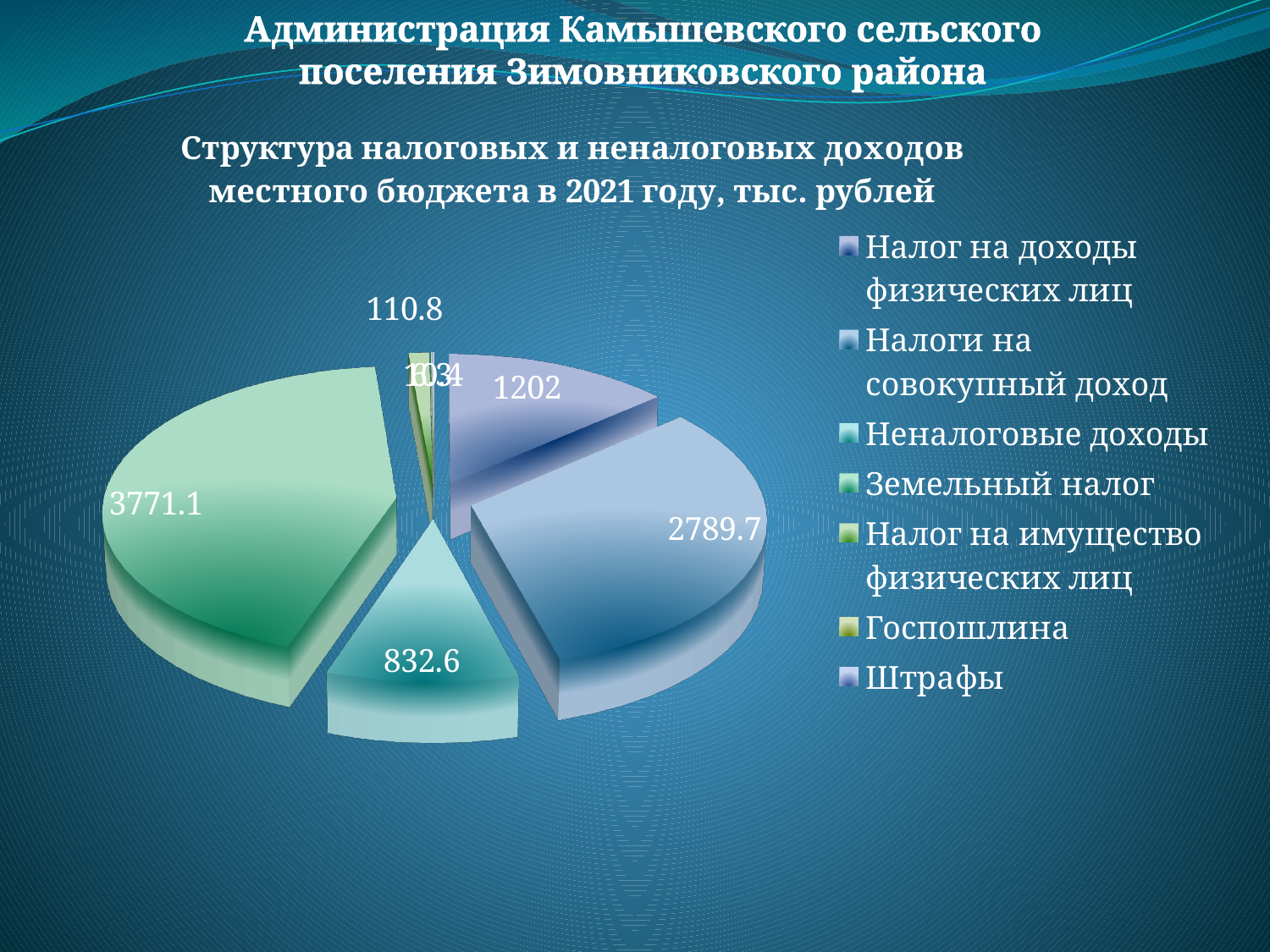
Which category has the largest slice of the pie? Земельный налог In what units are the values of the chart given, according to its title? тыс. рублей What is the difference between the values for Земельный налог and Налоги на совокупный доход? 981.4 What kind of chart is shown on the slide? Pie chart What is the value for Налоги на совокупный доход? 2789.7 What is the difference between the values for Налог на доходы физических лиц and Неналоговые доходы? 369.4 What is the value for Налог на доходы физических лиц? 1202 How many entries does the legend of the pie chart list? 7 What is the value for Неналоговые доходы? 832.6 What is the value for Налог на имущество физических лиц? 110.8 Which is larger: Налоги на совокупный доход or Налог на доходы физических лиц? Налоги на совокупный доход What is the value for Земельный налог? 3771.1